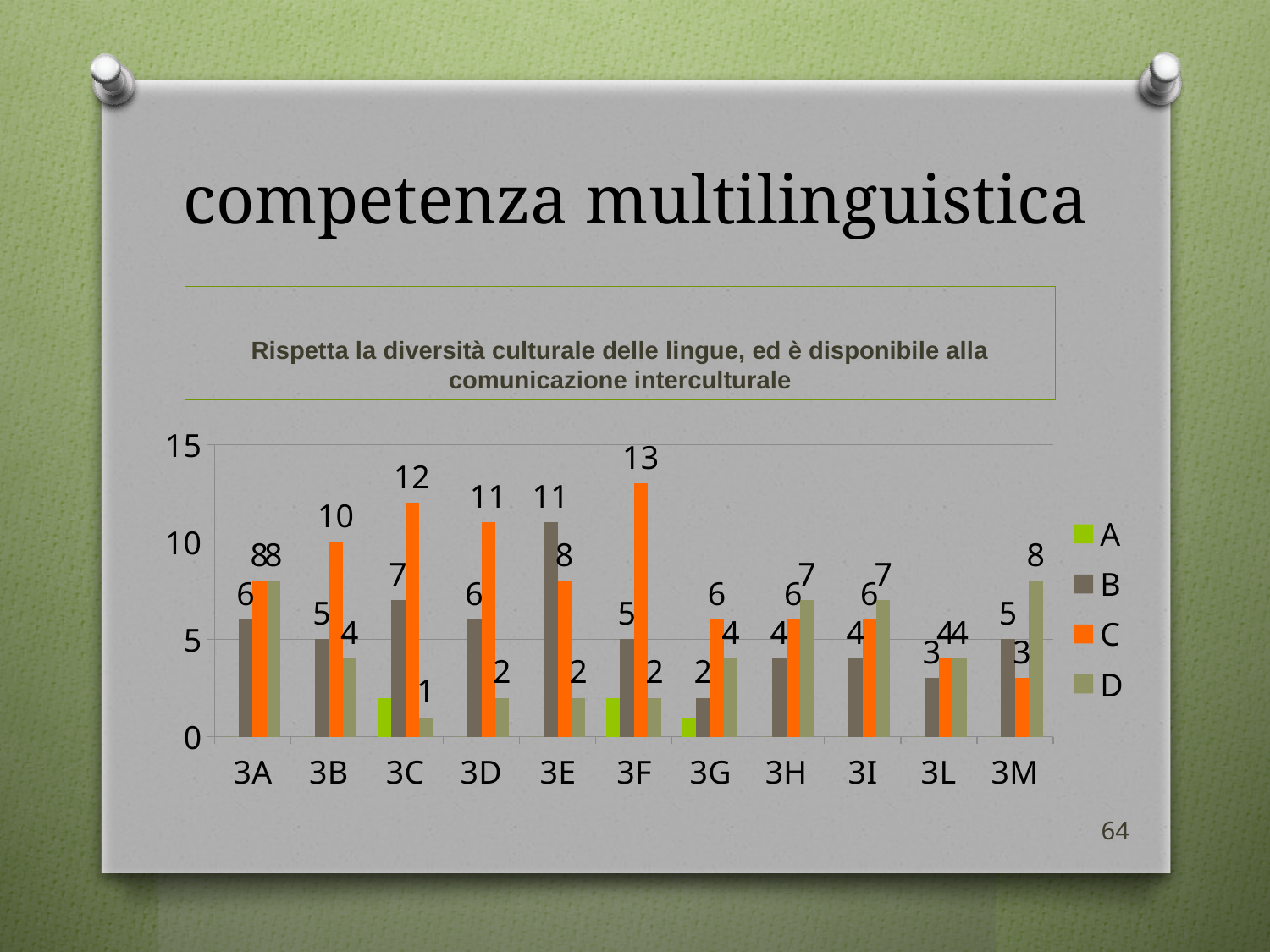
How many categories are shown on the x axis of the chart? 11 Which category has the lowest value for series D? 3C For category 3M, which is larger: series B or series C? B What is the value of series B for category 3E? 11 How many series does the chart legend list? 4 Which category has the highest value for series C? 3F What kind of chart is shown on the slide? bar chart What is the value of series D for category 3M? 8 What is the value of series C for category 3F? 13 What is the title of the slide containing the chart? competenza multilinguistica What is the value of series C for category 3B? 10 What is the difference between series C and series D for category 3C? 11